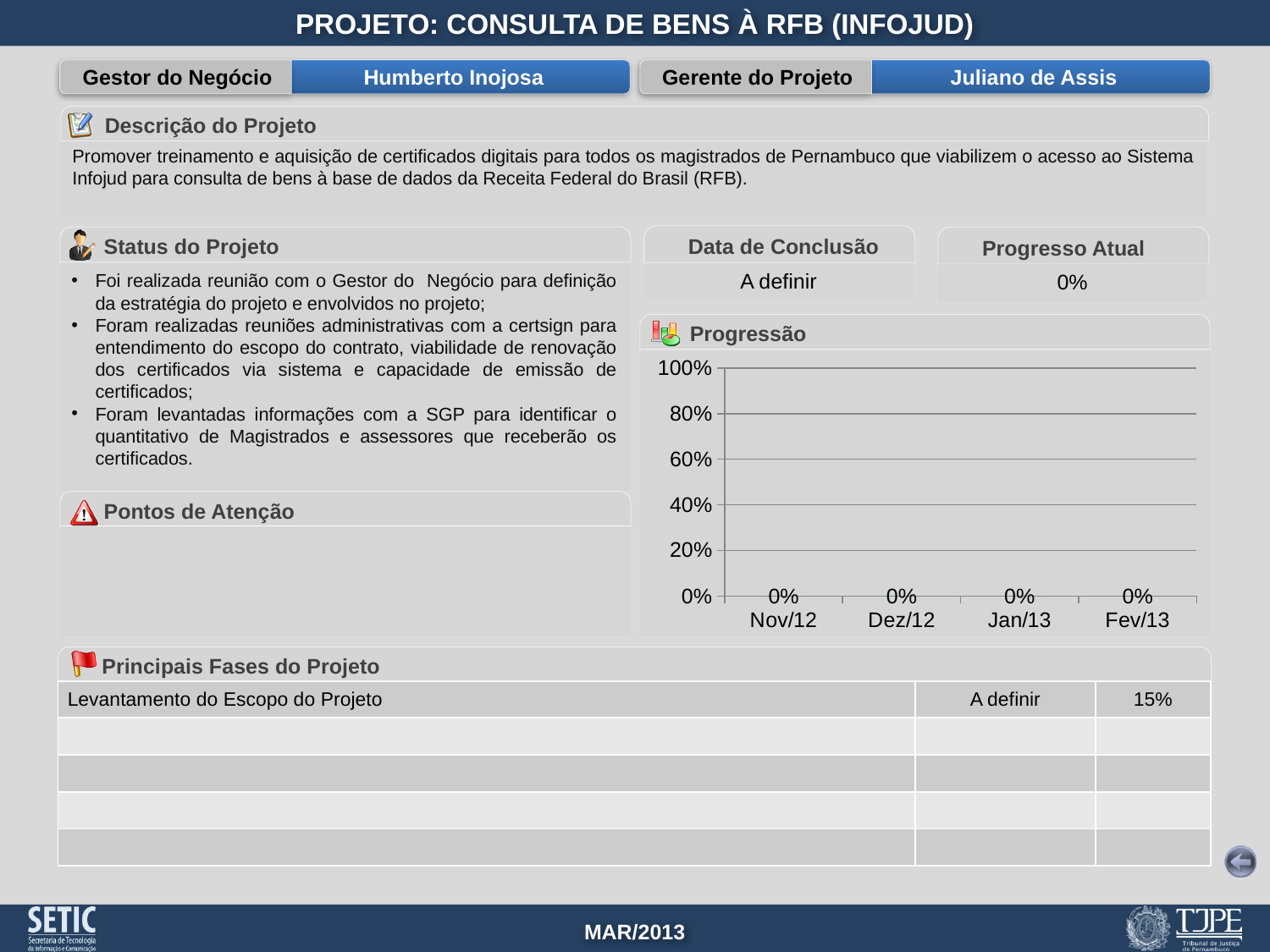
What is the value for Jan/13 in the Progressão chart? 0% What is the value for Nov/12 in the Progressão chart? 0% What is the difference between the values for Fev/13 and Nov/12 in the Progressão chart? 0% What is the value for Dez/12 in the Progressão chart? 0% Which is the first category on the x axis of the Progressão chart? Nov/12 What is the value for Fev/13 in the Progressão chart? 0% What is the title of the chart on the slide? Progressão Is the value for Jan/13 in the Progressão chart greater or less than 20%? less Do the values in the Progressão chart rise, fall, or stay flat from Nov/12 to Fev/13? stay flat How many categories are shown on the x axis of the Progressão chart? 4 What is the highest value shown on the y axis of the Progressão chart? 100%